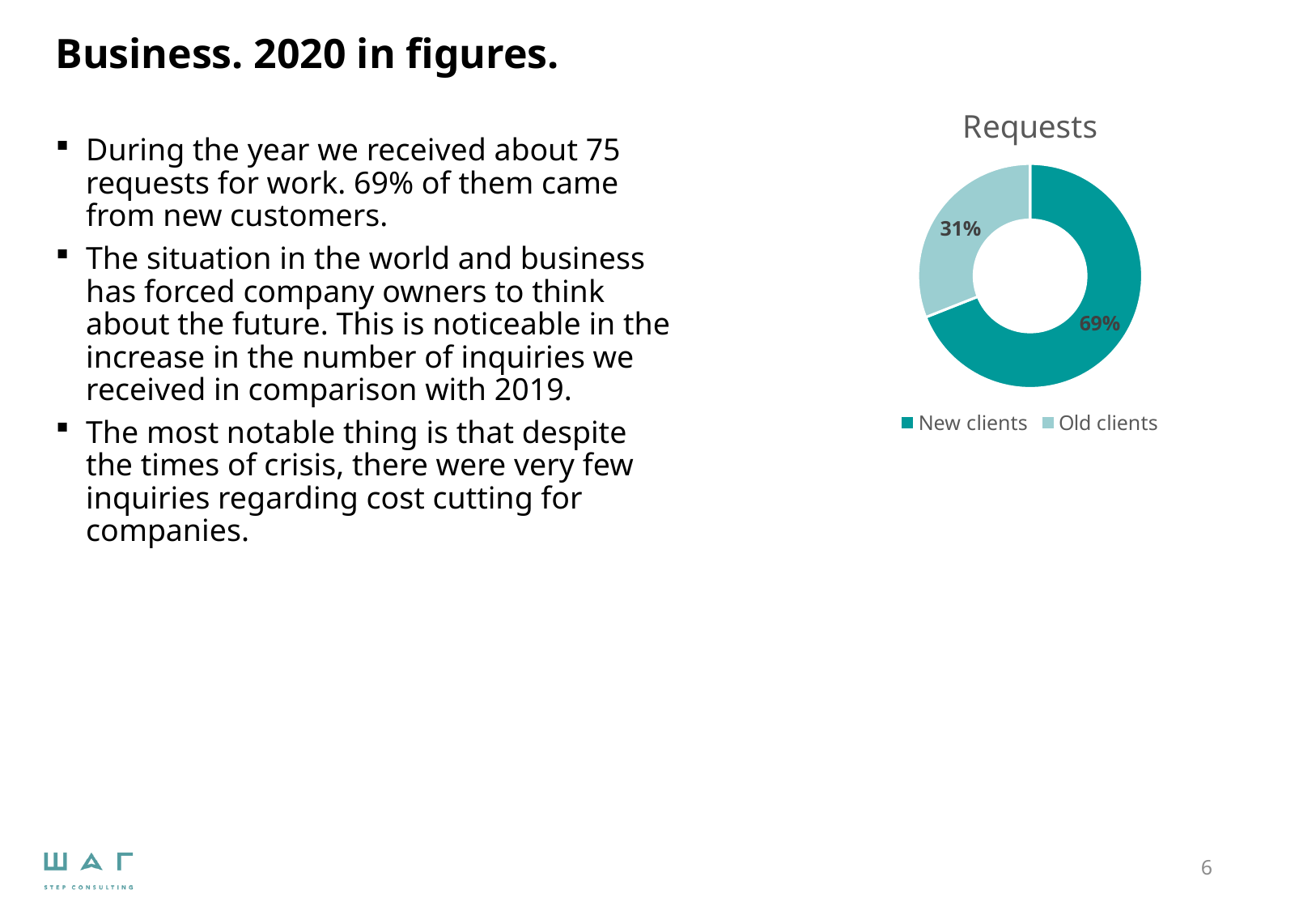
Which is larger: the share for new clients or the share for old clients? New clients Which category has the smallest share of requests? Old clients Which category has the largest share of requests? New clients What are the two legend entries of the chart? New clients, Old clients What is the total of the two shares shown in the chart? 100% What is the title of the chart? Requests What is the difference in percentage points between the new clients and old clients shares? 38 How many categories does the chart show? 2 What share of requests came from old clients? 31% What share of requests came from new clients? 69% What kind of chart is shown on the slide? Pie chart (doughnut)